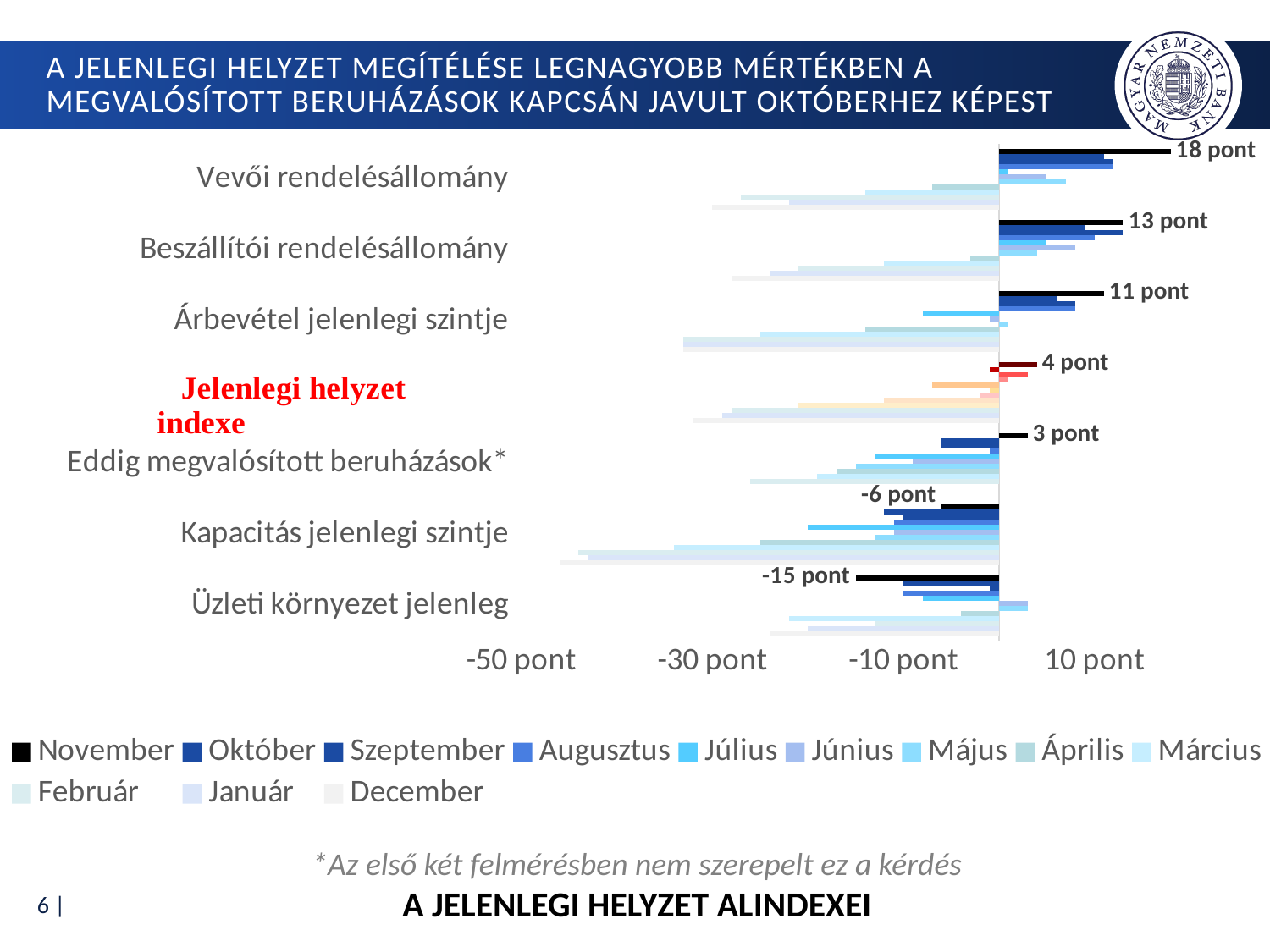
Which category has the highest November value? Vevői rendelésállomány What is the November value for Vevői rendelésállomány? 18 pont Which category has the lowest November value? Üzleti környezet jelenleg Which has a higher November value: Jelenlegi helyzet indexe or Eddig megvalósított beruházások*? Jelenlegi helyzet indexe What is the November value for Kapacitás jelenlegi szintje? -6 pont What is the difference between the November values for Vevői rendelésállomány and Árbevétel jelenlegi szintje? 7 pont What is the November value for Beszállítói rendelésállomány? 13 pont What is the November value for Üzleti környezet jelenleg? -15 pont How many series does the legend list? 12 How many categories are shown on the chart? 7 Which category's label is highlighted in red on the chart? Jelenlegi helyzet indexe What type of chart is shown on the slide? Bar chart